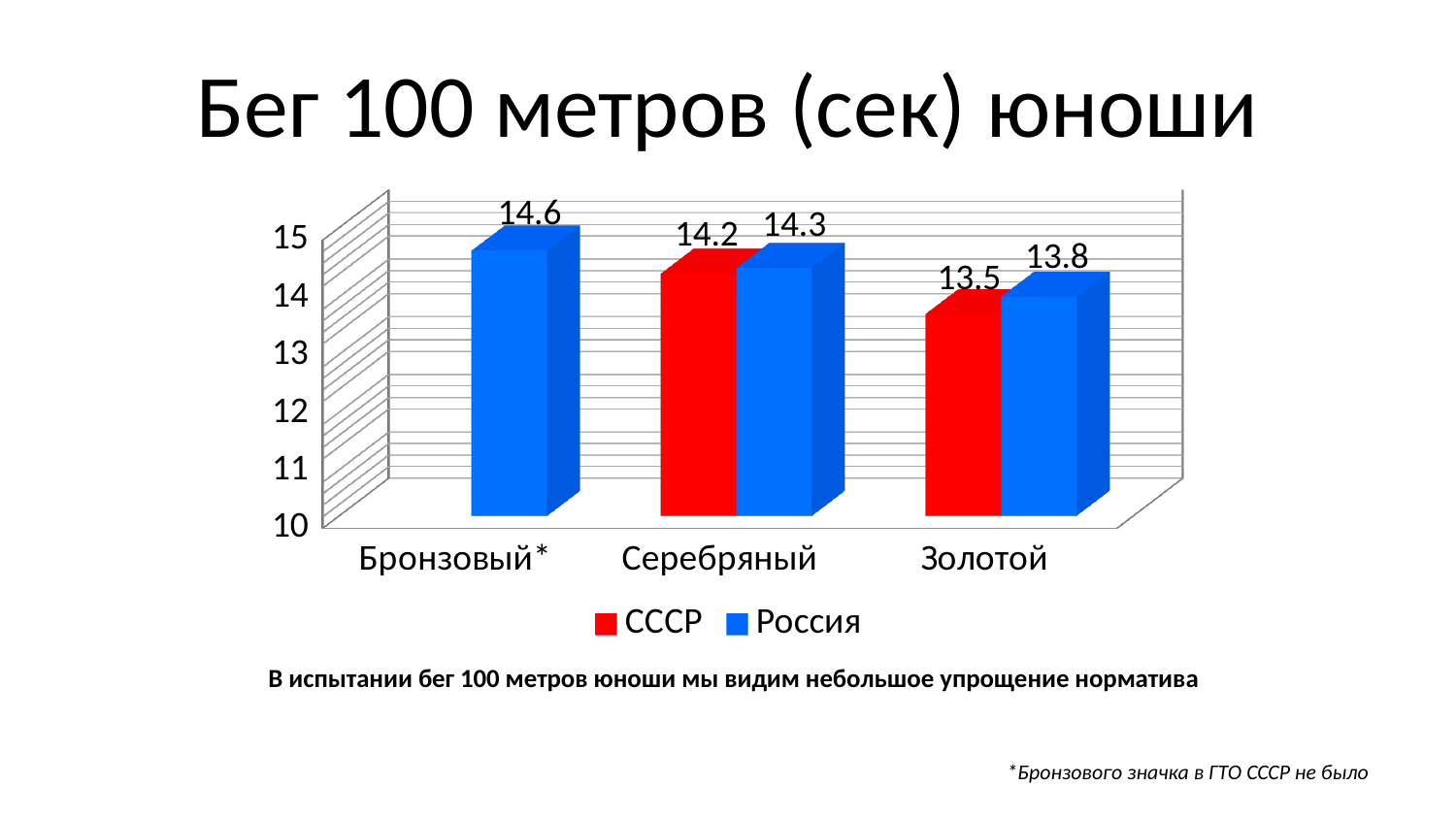
What is the title of the chart? Бег 100 метров (сек) юноши How many categories are shown on the x axis? 3 What is the value for Россия in the Золотой category? 13.8 What is the value for СССР in the Золотой category? 13.5 Which is larger in the Серебряный category: the СССР value or the Россия value? Россия What is the value for Россия in the Бронзовый category? 14.6 What is the difference between the Россия and СССР values in the Золотой category? 0.3 Which category has the lowest value for СССР? Золотой What kind of chart is shown on the slide? Bar chart What is the value for СССР in the Серебряный category? 14.2 Which category has the highest value for Россия? Бронзовый How many series does the legend list? 2